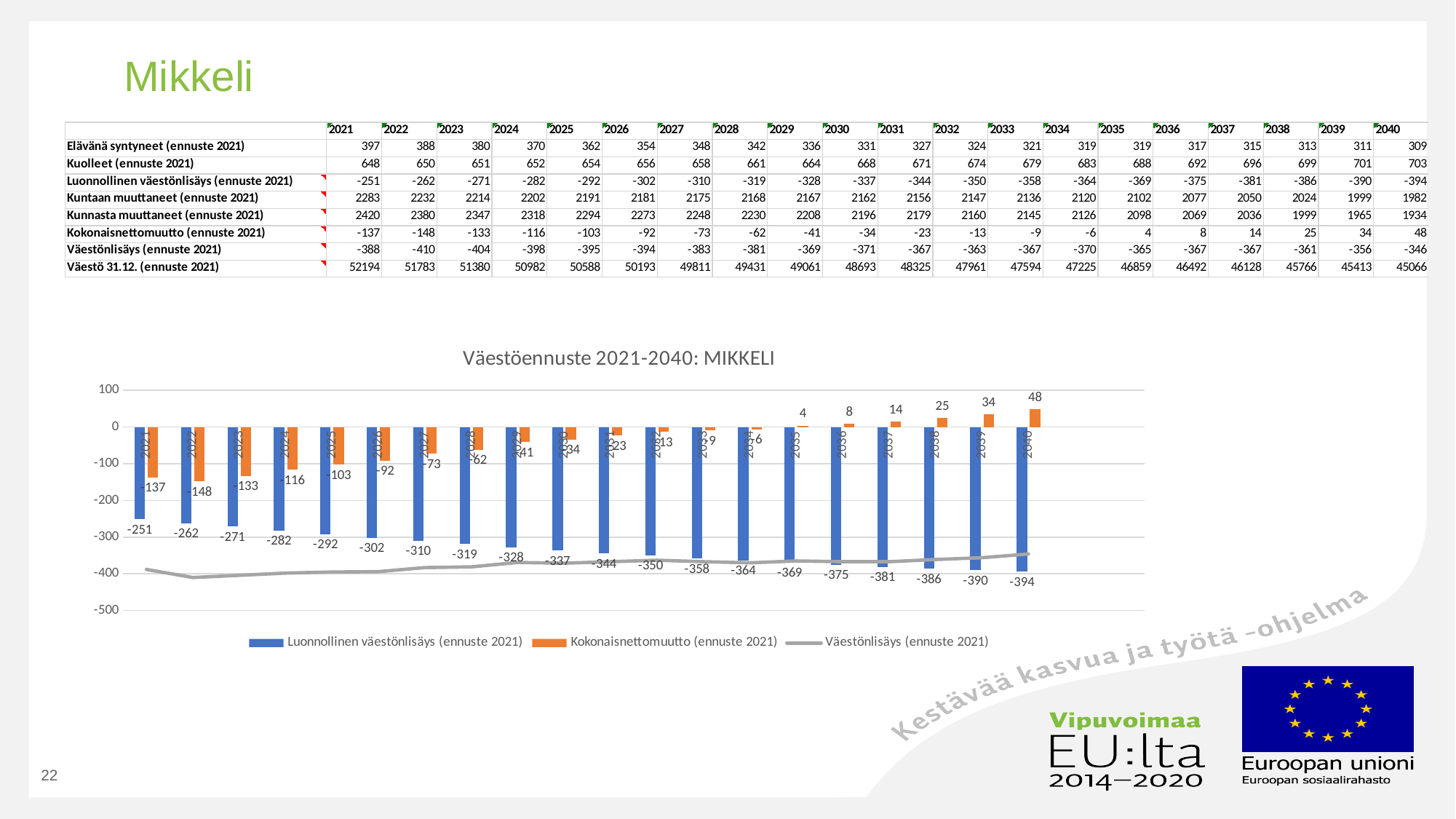
What is the value of Luonnollinen väestönlisäys (ennuste 2021) for 2021 in the chart? -251 In which year is Kokonaisnettomuutto (ennuste 2021) at its highest in the chart? 2040 Does Luonnollinen väestönlisäys (ennuste 2021) rise or fall from 2021 to 2040 in the chart? Fall What is the title of the chart? Väestöennuste 2021-2040: MIKKELI How many years are plotted along the x axis of the chart? 20 How many series does the chart legend list? 3 What is the value of Kokonaisnettomuutto (ennuste 2021) for 2040 in the chart? 48 What is the difference between Luonnollinen väestönlisäys (ennuste 2021) in 2021 and in 2040? 143 Which is larger in the chart: Kokonaisnettomuutto (ennuste 2021) for 2021 or for 2022? 2021 In which year is Luonnollinen väestönlisäys (ennuste 2021) at its lowest in the chart? 2040 What kind of chart is shown on the slide? Bar chart with a line In which year is Kokonaisnettomuutto (ennuste 2021) at its lowest in the chart? 2022